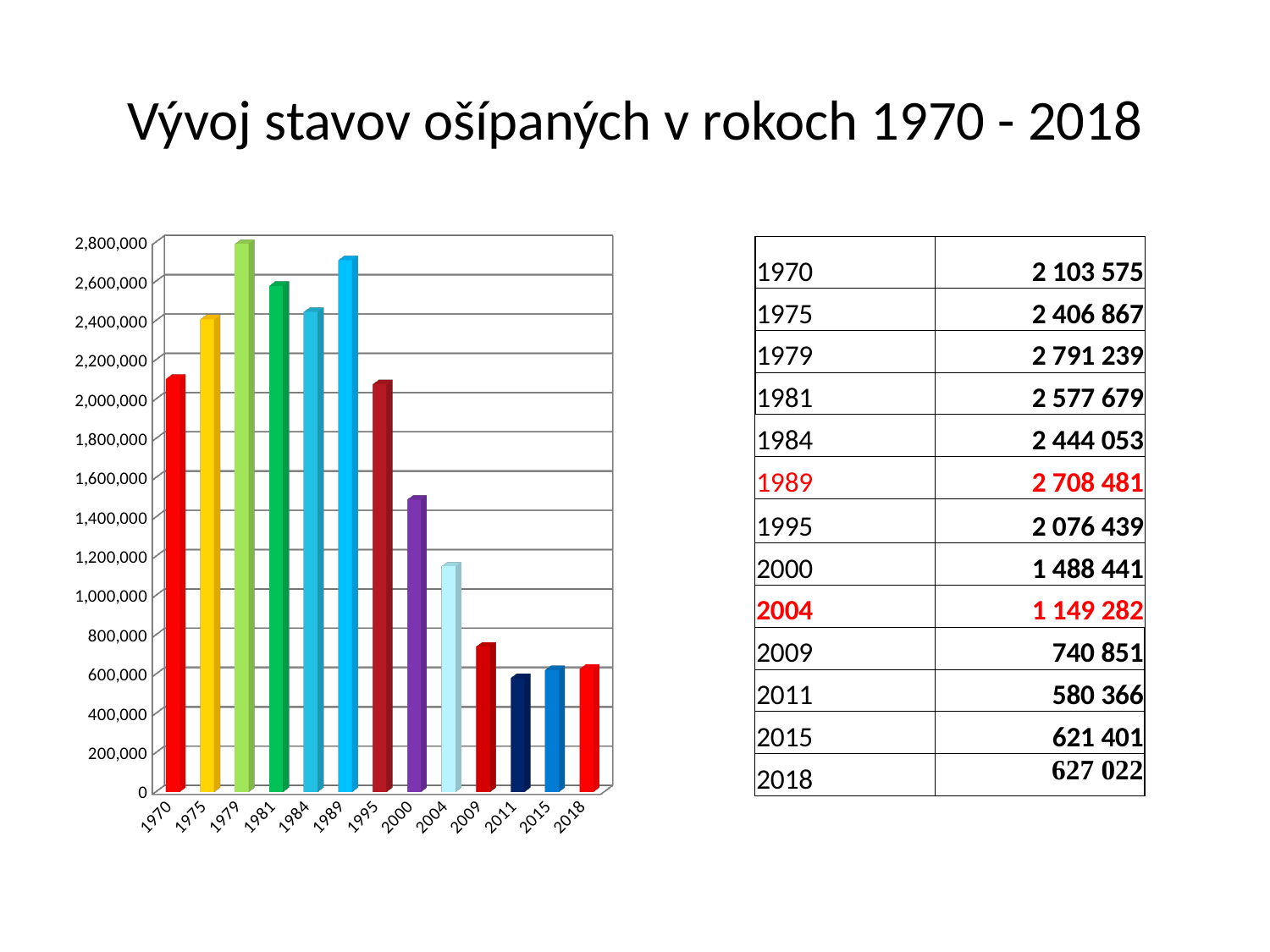
Which year has the highest value in the chart? 1979 How many years (bars) are plotted in the chart? 13 Is the value for 2009 greater or less than 800,000? less What is the value for 2004 according to the slide? 1 149 282 What is the value for 2018 according to the slide? 627 022 Which year has the lowest value in the chart? 2011 What is the difference between the values for 1970 and 1975 as printed on the slide? 303 292 What is the value for 1989 according to the slide? 2 708 481 Is the value for 2000 greater or less than 1,400,000? greater What kind of chart is shown on the slide? bar chart Which is larger, the value for 1981 or the value for 1984? 1981 Do the values generally rise or fall from 1989 to 2011? fall